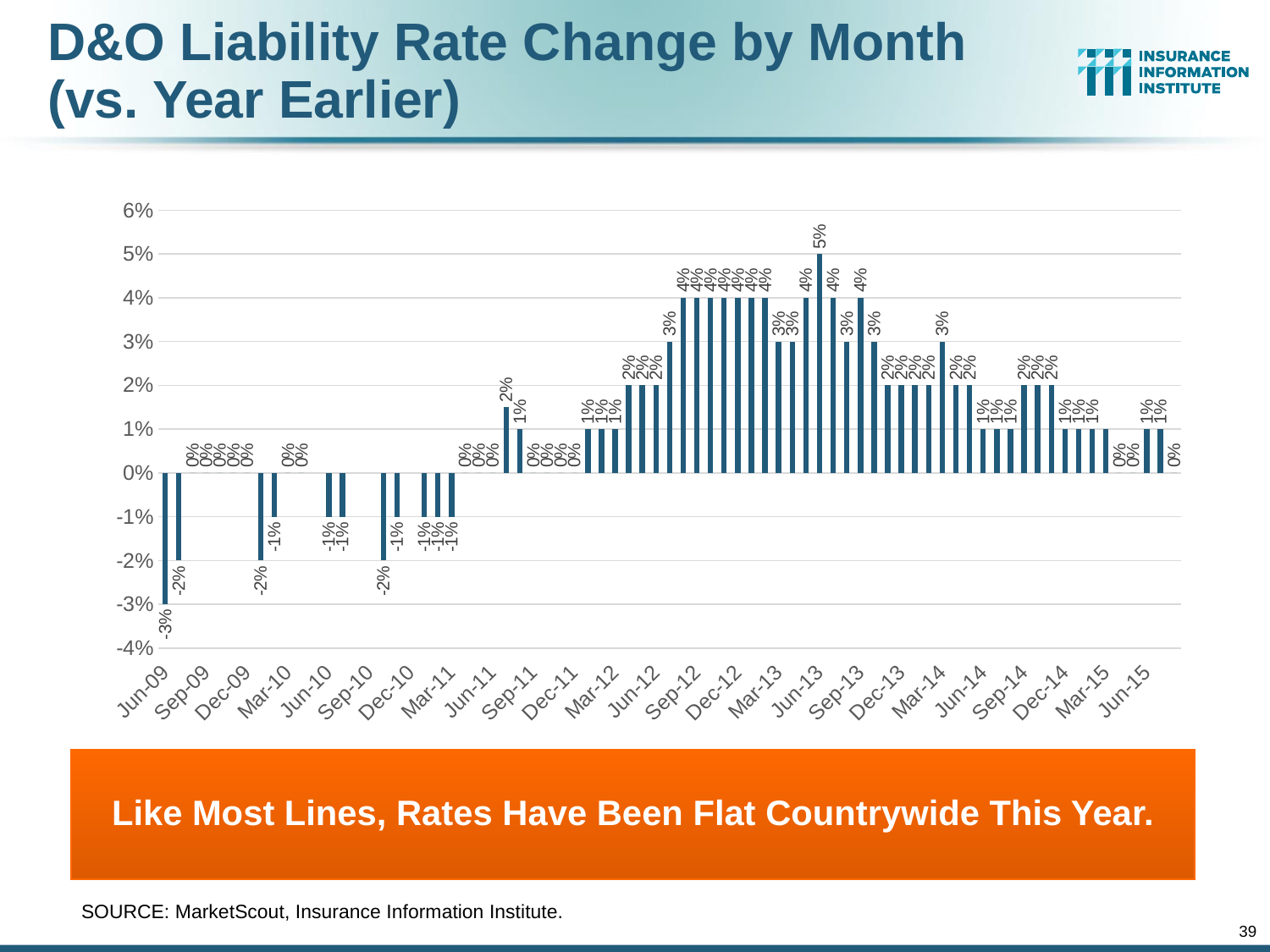
What is the highest rate change value shown on the chart? 5% What kind of chart is shown on the slide? Bar chart What is the title of the chart on the slide? D&O Liability Rate Change by Month (vs. Year Earlier) What is the D&O liability rate change for Jun-15? 1% How many bars on the chart reach 5%? 1 What is the D&O liability rate change for Jun-09? -3% Do the values generally rise or fall from the 5% peak to Jun-15? fall Which is larger, the rate change for Jun-09 or for Jun-15? Jun-15 What is the difference between the highest value (5%) and the lowest value (-3%) on the chart? 8 percentage points Is the value for Jun-09 greater or less than -2%? less What is the lowest rate change value shown on the chart? -3% What is the range of the vertical axis on the chart? -4% to 6%